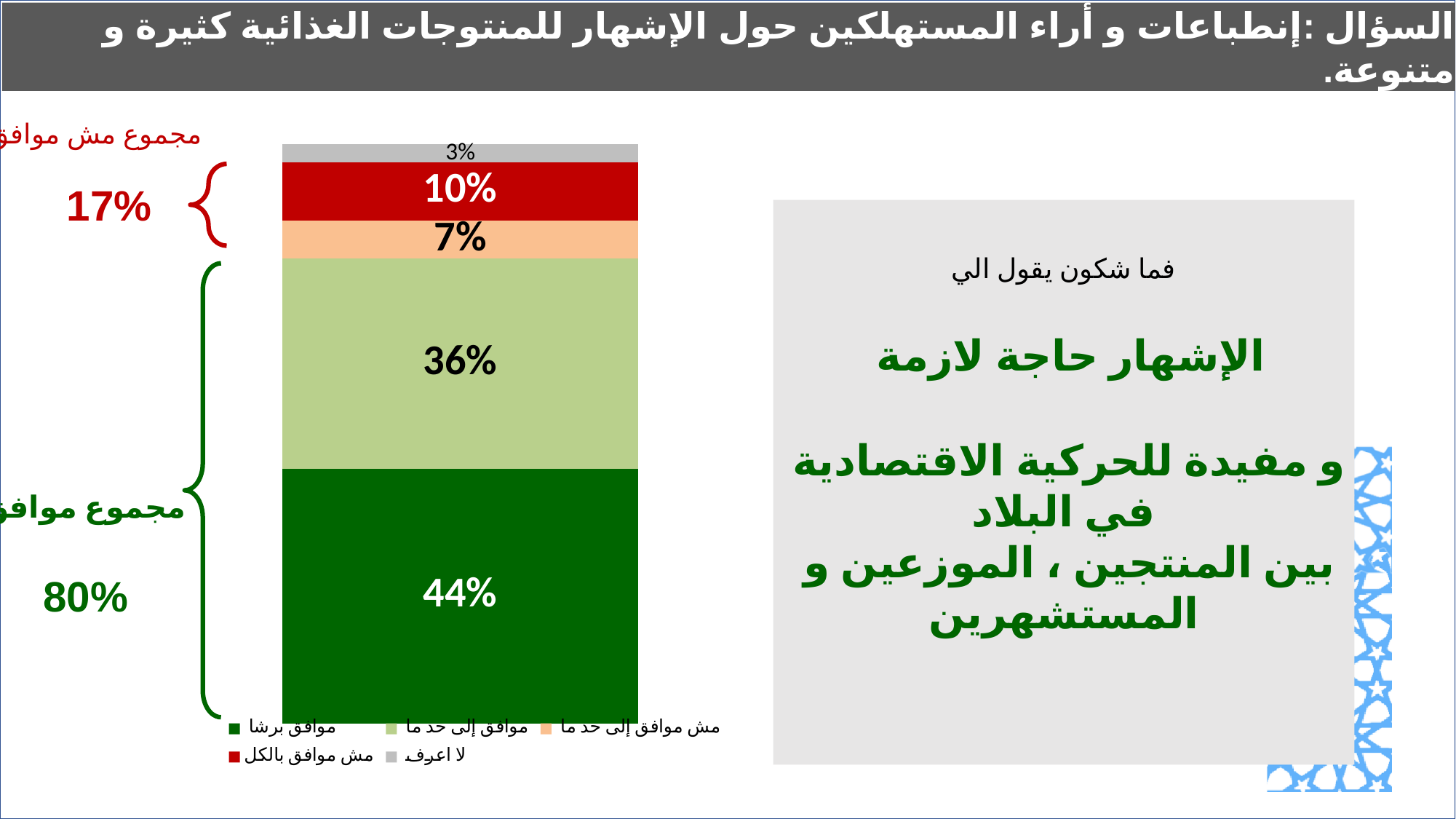
What percentage is shown for the dark green segment (موافق برشا) in the stacked bar? 44% What percentage is shown for the light green segment (موافق إلى حد ما)? 36% What is the difference between the موافق برشا segment and the موافق إلى حد ما segment? 8% What percentage is shown for the red segment (مش موافق بالكل)? 10% What type of chart is shown on the slide? Stacked bar chart Which is larger, the مش موافق بالكل segment or the مش موافق إلى حد ما segment? مش موافق بالكل What percentage is shown for the peach segment (مش موافق إلى حد ما)? 7% What total percentage is given for مجموع موافق (total agree) next to the bar? 80% Which segment of the stacked bar has the largest value? موافق برشا (44%) What percentage is shown for the grey segment (لا اعرف) at the top of the bar? 3% Which segment of the stacked bar has the smallest value? لا اعرف (3%) How many segments (categories) does the stacked bar contain? 5